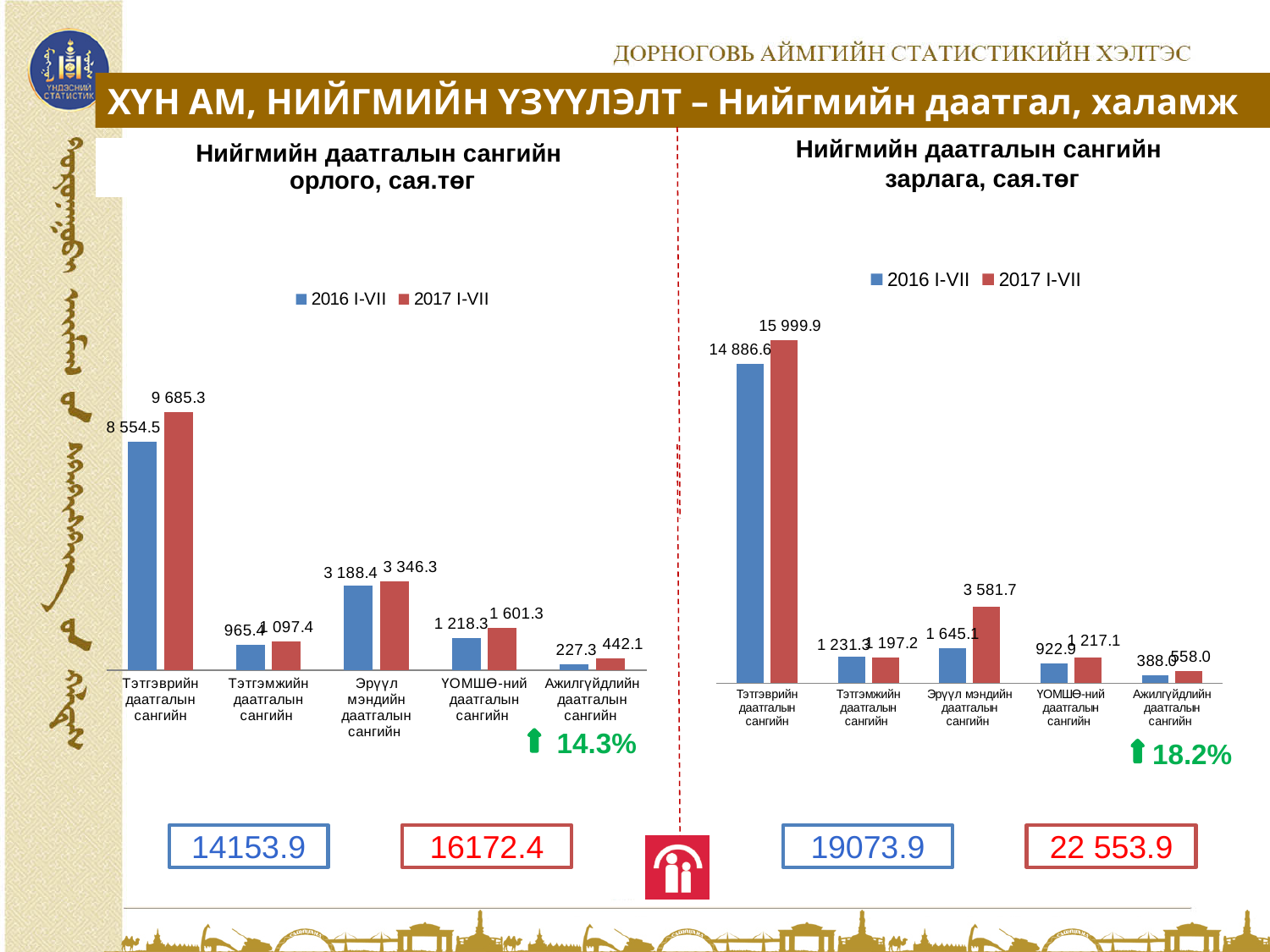
In the left chart (Нийгмийн даатгалын сангийн орлого), which category has the highest 2017 I-VII value? Тэтгэврийн даатгалын сангийн In the right chart (Нийгмийн даатгалын сангийн зарлага), which is larger for Тэтгэмжийн даатгалын сангийн: the 2016 I-VII value or the 2017 I-VII value? 2016 I-VII What type of chart is the right chart (Нийгмийн даатгалын сангийн зарлага)? Bar chart In the left chart (Нийгмийн даатгалын сангийн орлого), which category has the lowest 2016 I-VII value? Ажилгүйдлийн даатгалын сангийн In the right chart (Нийгмийн даатгалын сангийн зарлага), what is the difference between the 2017 I-VII and 2016 I-VII values for Эрүүл мэндийн даатгалын сангийн? 1 936.6 In the left chart (Нийгмийн даатгалын сангийн орлого), what is the 2017 I-VII value for Тэтгэврийн даатгалын сангийн? 9 685.3 In the right chart (Нийгмийн даатгалын сангийн зарлага), what is the 2016 I-VII value for Тэтгэврийн даатгалын сангийн? 14 886.6 In the right chart (Нийгмийн даатгалын сангийн зарлага), what is the 2017 I-VII value for Эрүүл мэндийн даатгалын сангийн? 3 581.7 How many categories are shown on the x axis of the left chart (Нийгмийн даатгалын сангийн орлого)? 5 In the left chart (Нийгмийн даатгалын сангийн орлого), what is the difference between the 2017 I-VII and 2016 I-VII values for Тэтгэврийн даатгалын сангийн? 1 130.8 In the left chart (Нийгмийн даатгалын сангийн орлого), what is the 2016 I-VII value for Эрүүл мэндийн даатгалын сангийн? 3 188.4 How many series does the legend of the right chart (Нийгмийн даатгалын сангийн зарлага) list? 2